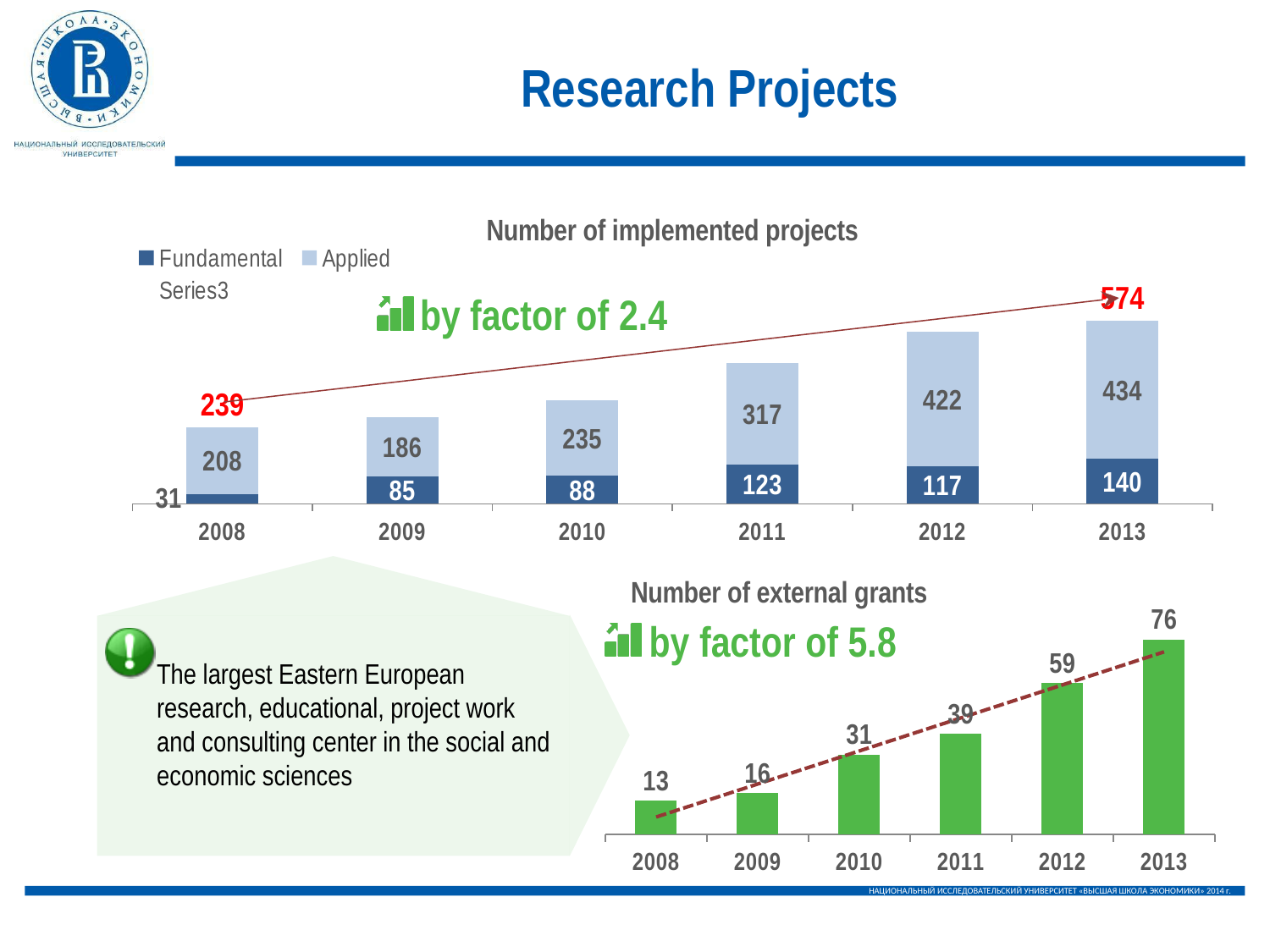
In the 'Number of external grants' chart, what is the value for 2010? 31 In the 'Number of implemented projects' chart, what is the Applied value for 2012? 422 In the 'Number of implemented projects' chart, what is the difference between the Applied values for 2013 and 2008? 226 In the 'Number of implemented projects' chart, what is the Fundamental value for 2011? 123 In the 'Number of external grants' chart, do the values rise or fall from 2008 to 2013? rise In the 'Number of implemented projects' chart, how many entries does the legend list? 3 In the 'Number of external grants' chart, what is the difference between the values for 2012 and 2011? 20 In the 'Number of implemented projects' chart, which is larger: the Fundamental value for 2012 or for 2013? 2013 In the 'Number of implemented projects' chart, what is the total of the stacked bar for 2013? 574 In the 'Number of implemented projects' chart, how many years are shown on the x axis? 6 In the 'Number of external grants' chart, which year has the highest value? 2013 In the 'Number of implemented projects' chart, which year has the lowest Fundamental value? 2008